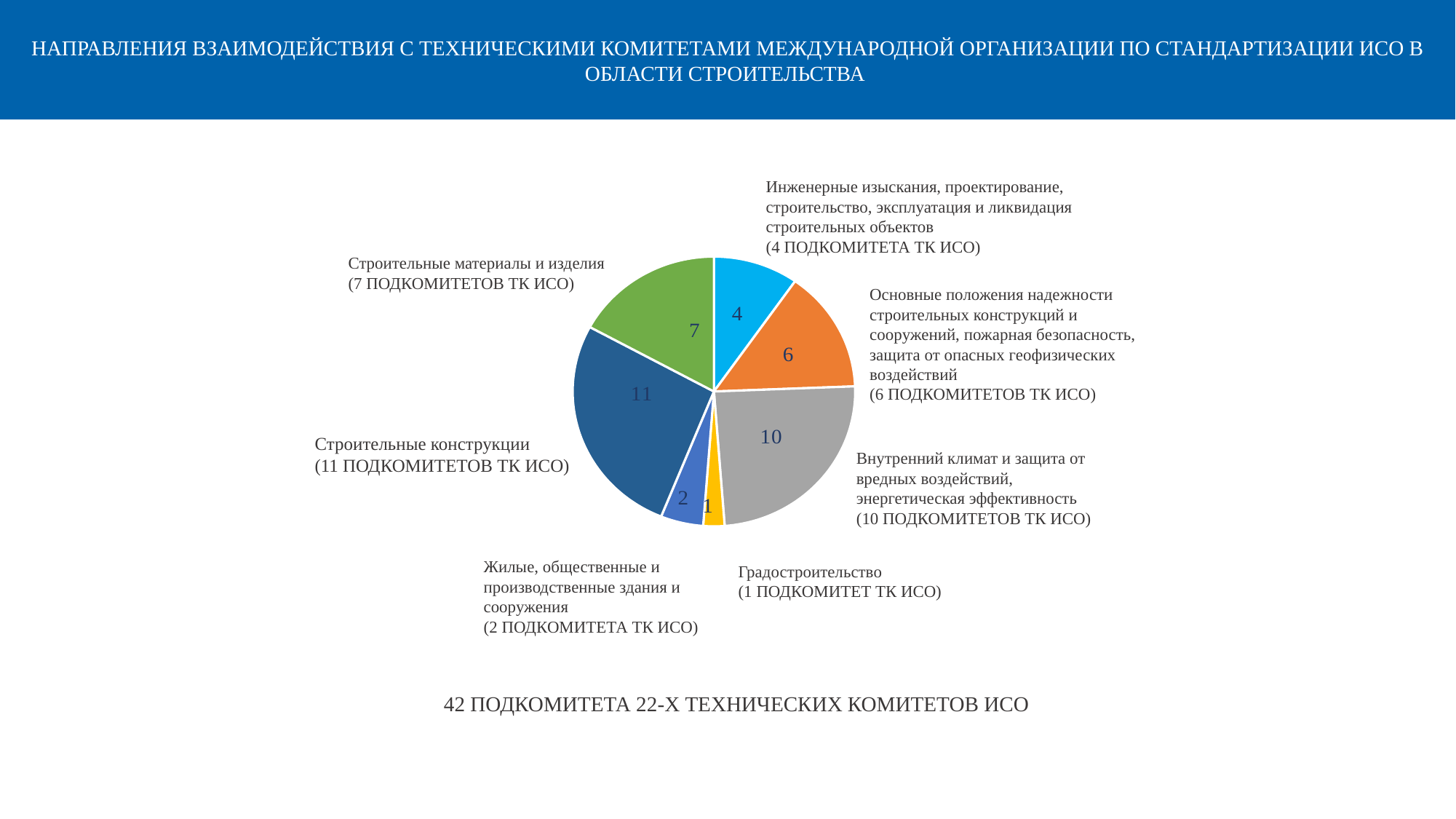
Which is larger: the slice for Основные положения надежности строительных конструкций (6) or the slice for Инженерные изыскания (4)? Основные положения надежности строительных конструкций What is the difference between the values for Строительные конструкции and Строительные материалы и изделия? 4 Which category has the smallest slice in the pie chart? Градостроительство What is the value of the slice for Внутренний климат и защита от вредных воздействий, энергетическая эффективность? 10 What is the value of the slice for Строительные конструкции? 11 How many slices does the pie chart have? 7 What is the value of the slice for Строительные материалы и изделия? 7 What is the value of the slice for Градостроительство? 1 What colour is the slice for Строительные материалы и изделия? green Which category has the largest slice in the pie chart? Строительные конструкции What type of chart is shown on the slide? pie chart What is the difference between the values for Внутренний климат и защита от вредных воздействий and Жилые, общественные и производственные здания и сооружения? 8